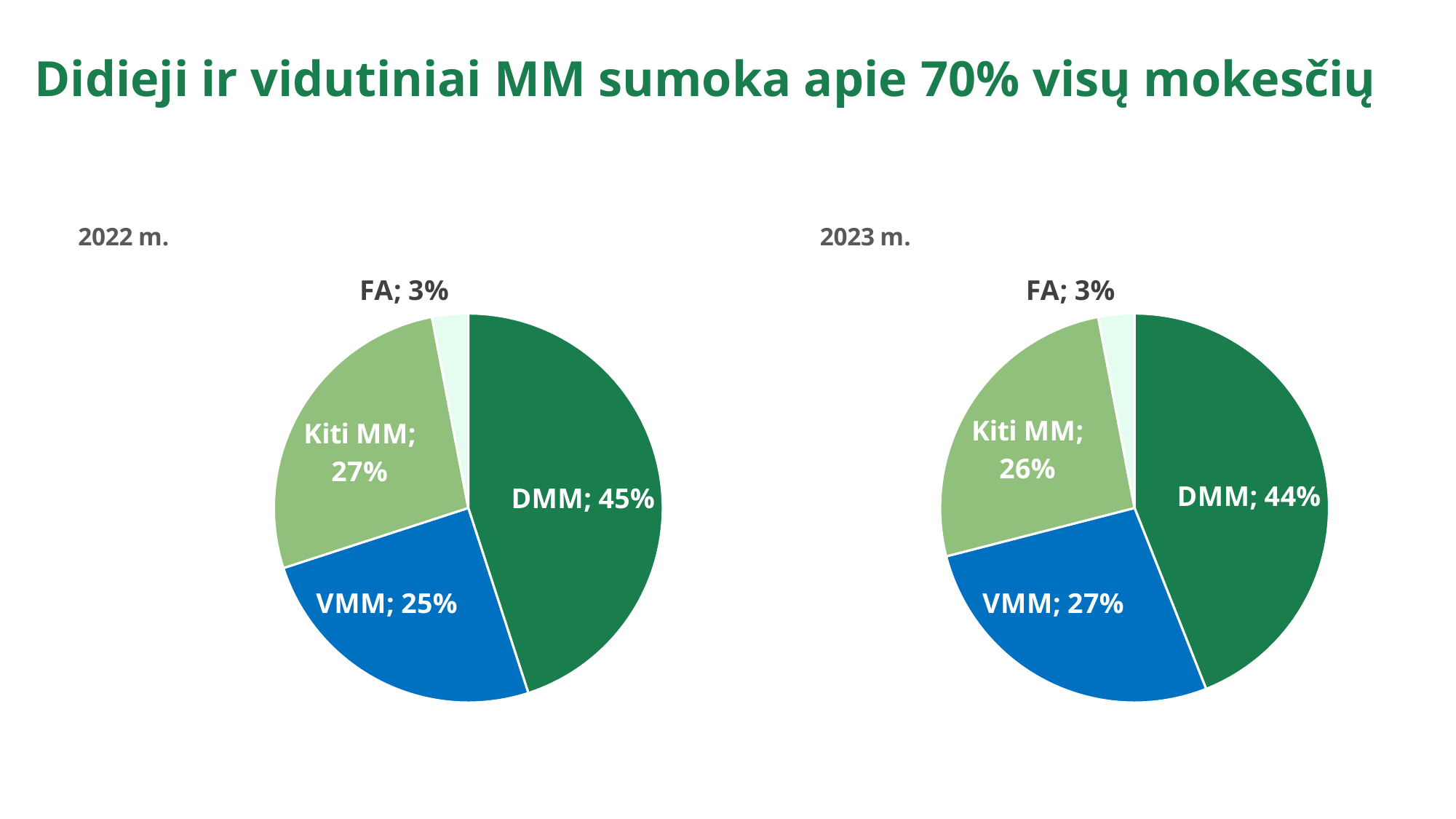
In the 2022 m. pie chart, what is the difference between the DMM and VMM values? 20% In the 2023 m. pie chart, which category has the smallest slice? FA How many slices does the 2022 m. pie chart have? 4 In the 2022 m. pie chart, what is the value for DMM? 45% What colour is the VMM slice in the 2022 m. pie chart? Blue In the 2023 m. pie chart, what is the value for FA? 3% In the 2022 m. pie chart, what is the combined share of DMM and VMM? 70% In the 2023 m. pie chart, what is the value for VMM? 27% In the 2022 m. pie chart, which category has the largest slice? DMM What kind of chart is the 2023 m. chart? Pie chart In the 2023 m. pie chart, what is the value for Kiti MM? 26% In the 2023 m. pie chart, which is larger, DMM or Kiti MM? DMM